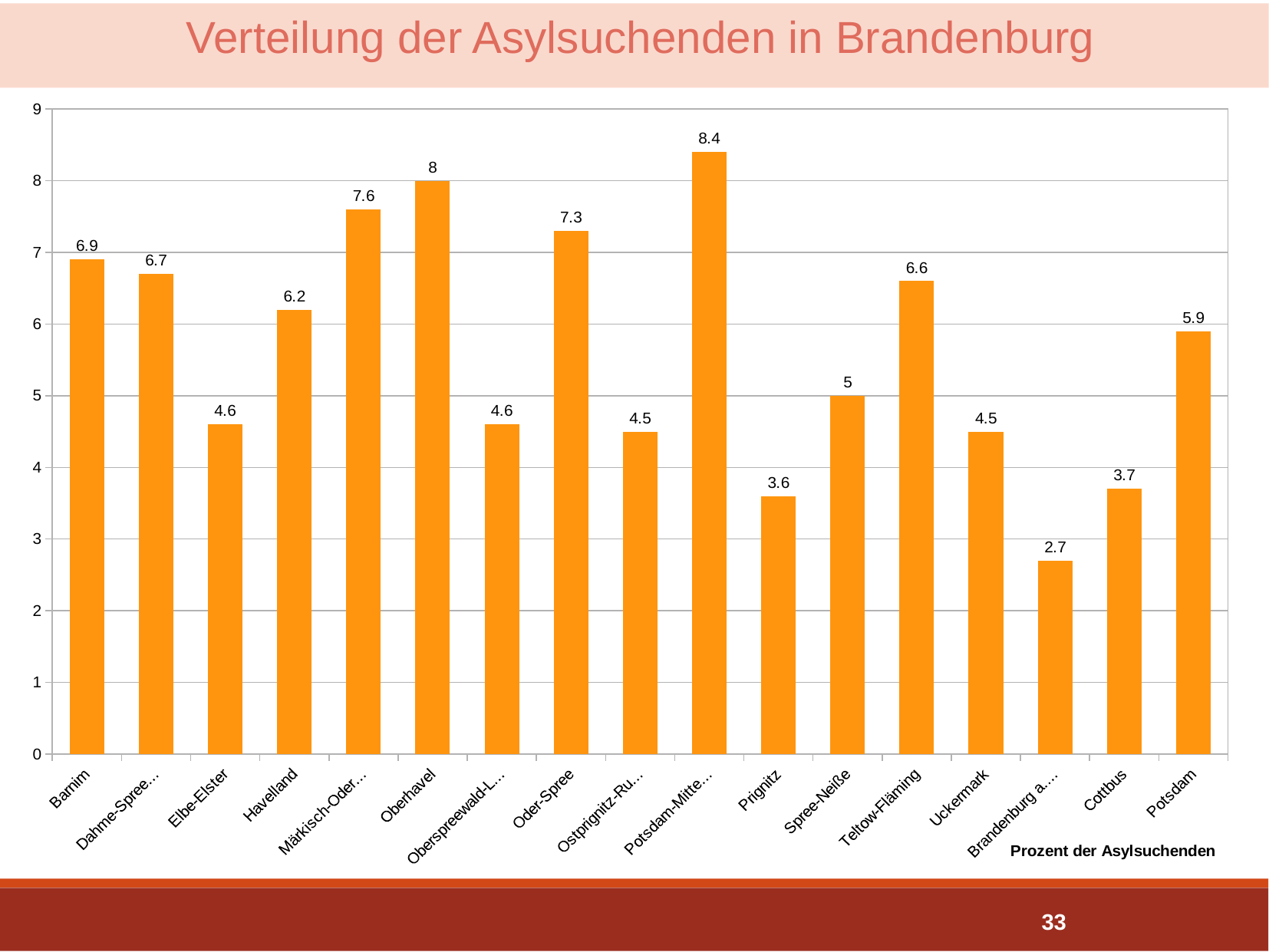
What is the title of the slide? Verteilung der Asylsuchenden in Brandenburg What is the value for Potsdam? 5.9 What is the lowest value shown in the chart? 2.7 What is the value for Oberhavel? 8 What is the value for Cottbus? 3.7 What is the highest value shown in the chart? 8.4 How many bars are shown in the chart? 17 What is the value for Barnim? 6.9 What is the difference between the values for Oberhavel and Havelland? 1.8 What is the value for Prignitz? 3.6 Which has a larger value, Teltow-Fläming or Spree-Neiße? Teltow-Fläming What kind of chart is shown on the slide? bar chart